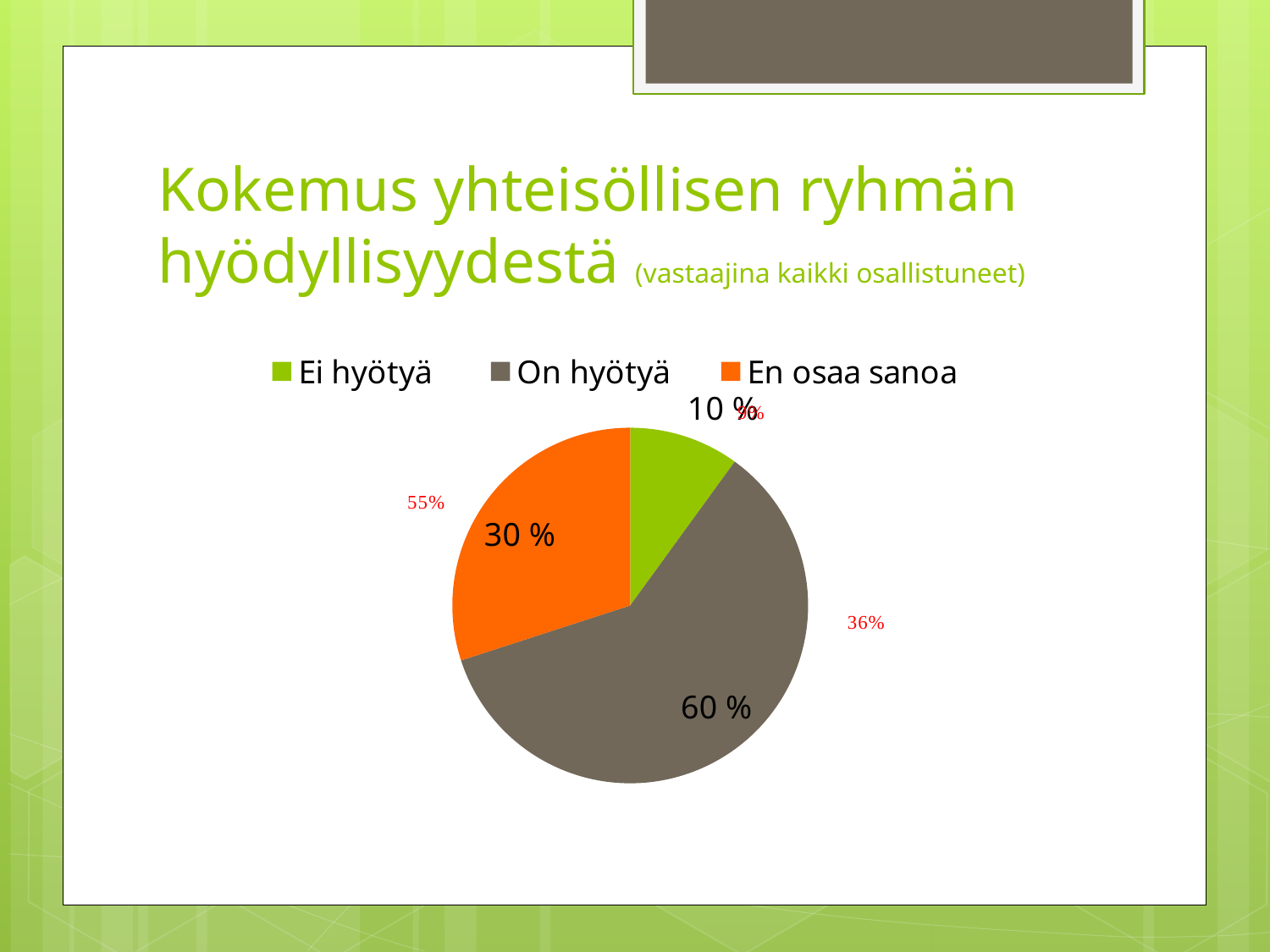
What percentage is shown for the "Ei hyötyä" slice? 10 % What percentage is shown for the "On hyötyä" slice? 60 % Which category has the largest slice of the pie? On hyötyä Which category has the smallest slice of the pie? Ei hyötyä How many slices does the pie chart have? 3 How many entries does the legend list? 3 What colour is the "En osaa sanoa" slice? orange What percentage is shown for the "En osaa sanoa" slice? 30 % What share of the pie does the "On hyötyä" slice represent? 60 % Which slice is larger, "En osaa sanoa" or "Ei hyötyä"? En osaa sanoa What is the difference in percentage points between the "On hyötyä" and "En osaa sanoa" slices? 30 What kind of chart is shown on the slide? pie chart